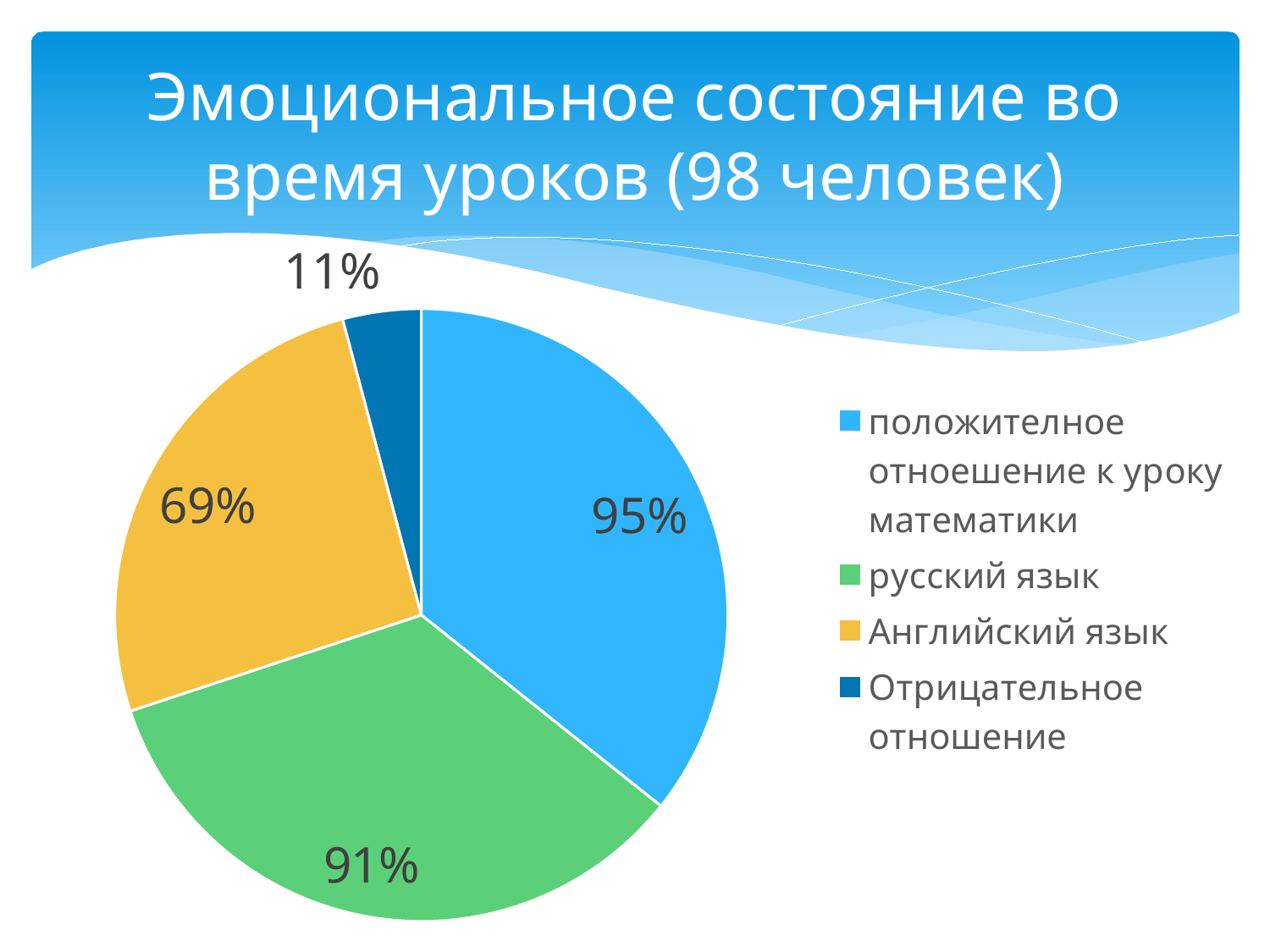
What colour is the slice for "Английский язык"? Yellow What value is labelled on the slice for "Отрицательное отношение"? 11% What value is labelled on the slice for "положителное отноешение к уроку математики"? 95% Which is larger, the value for "Английский язык" or the value for "Отрицательное отношение"? Английский язык What value is labelled on the slice for "русский язык"? 91% Which category has the smallest slice in the pie chart? Отрицательное отношение How many categories does the legend list? 4 What type of chart is shown on the slide? Pie chart What is the title of the chart on the slide? Эмоциональное состояние во время уроков (98 человек) Which category has the largest slice in the pie chart? положителное отноешение к уроку математики What value is labelled on the slice for "Английский язык"? 69% What is the difference between the labelled values for "русский язык" and "Английский язык"? 22%